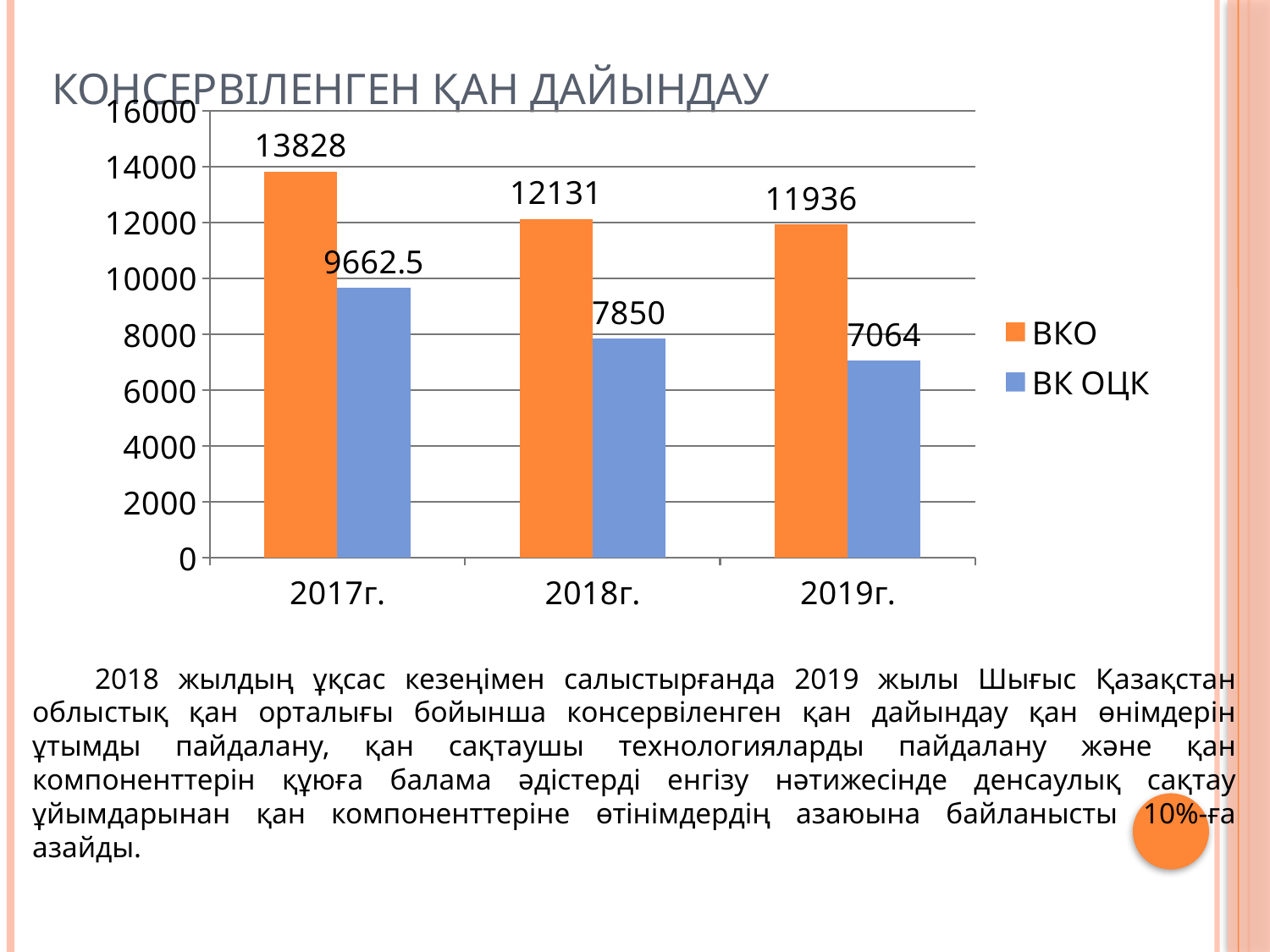
What is the value for ВК ОЦК in 2018г.? 7850 Which year has the highest value for ВКО? 2017г. Which is larger in 2018г., ВКО or ВК ОЦК? ВКО What is the value for ВКО in 2017г.? 13828 Do the ВК ОЦК values rise or fall from 2017г. to 2019г.? fall What kind of chart is shown on the slide? bar chart Which year has the lowest value for ВК ОЦК? 2019г. How many series does the legend list? 2 What is the difference between ВКО and ВК ОЦК in 2019г.? 4872 What is the value for ВК ОЦК in 2019г.? 7064 What is the difference between the ВКО values for 2017г. and 2018г.? 1697 How many years are shown on the x axis? 3